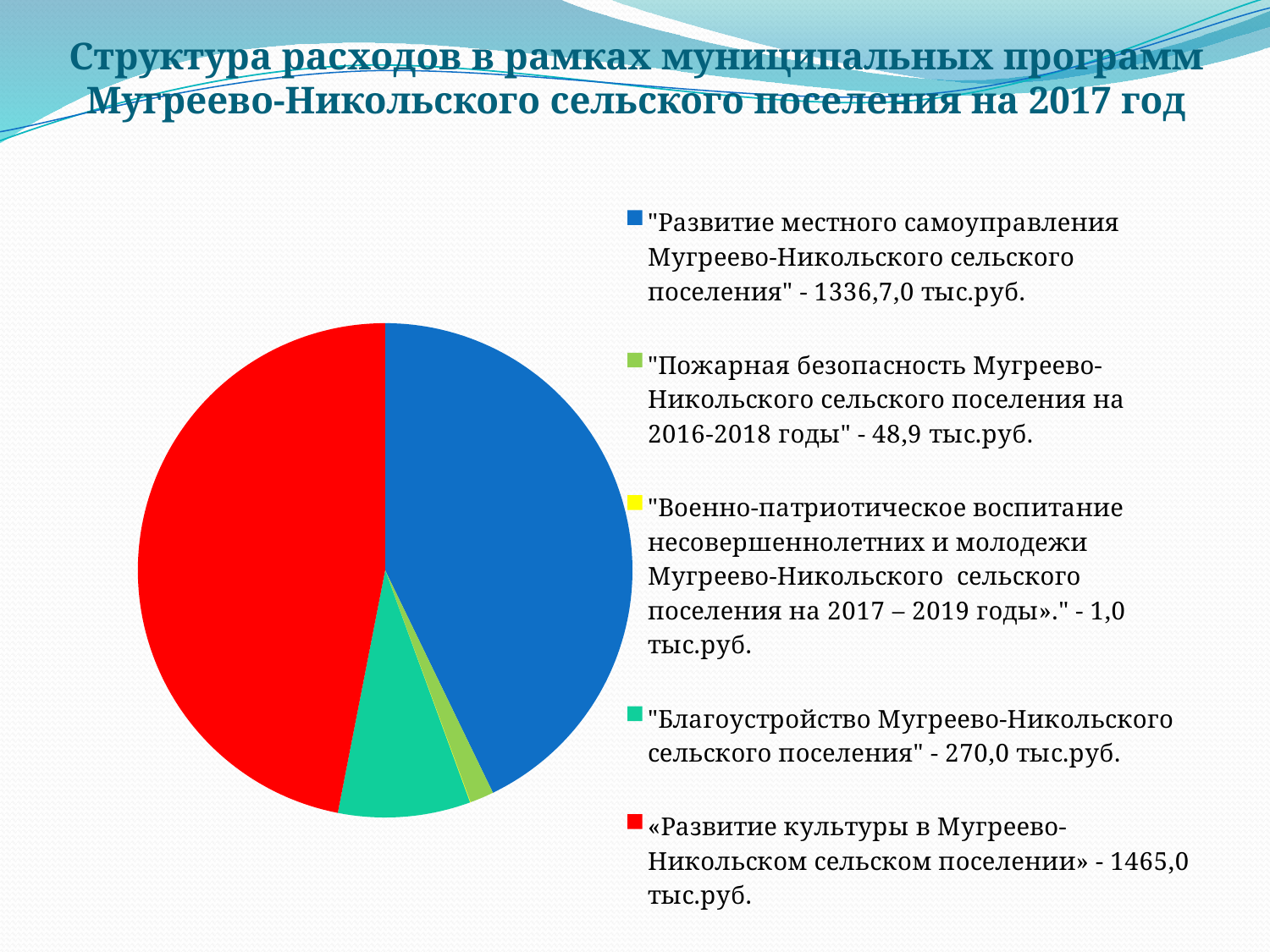
What colour is the slice for «Развитие культуры в Мугреево-Никольском сельском поселении»? red How many slices does the pie chart have? 5 What kind of chart is shown on the slide? pie chart What is the expenditure for "Пожарная безопасность Мугреево-Никольского сельского поселения на 2016-2018 годы" according to the legend? 48,9 тыс.руб. What is the difference between the expenditure for «Развитие культуры» (1465,0) and for "Благоустройство" (270,0)? 1195,0 тыс.руб. What is the expenditure for "Благоустройство Мугреево-Никольского сельского поселения" according to the legend? 270,0 тыс.руб. How many entries does the legend list? 5 Which programme has the smallest share of expenditure in the pie chart? "Военно-патриотическое воспитание несовершеннолетних и молодежи Мугреево-Никольского сельского поселения на 2017 – 2019 годы»" Which is larger: the expenditure for "Благоустройство" or for "Пожарная безопасность"? "Благоустройство Мугреево-Никольского сельского поселения" Which programme has the largest share of expenditure in the pie chart? «Развитие культуры в Мугреево-Никольском сельском поселении» What year does the chart title say the expenditure structure refers to? 2017 What is the expenditure for «Развитие культуры в Мугреево-Никольском сельском поселении» according to the legend? 1465,0 тыс.руб.